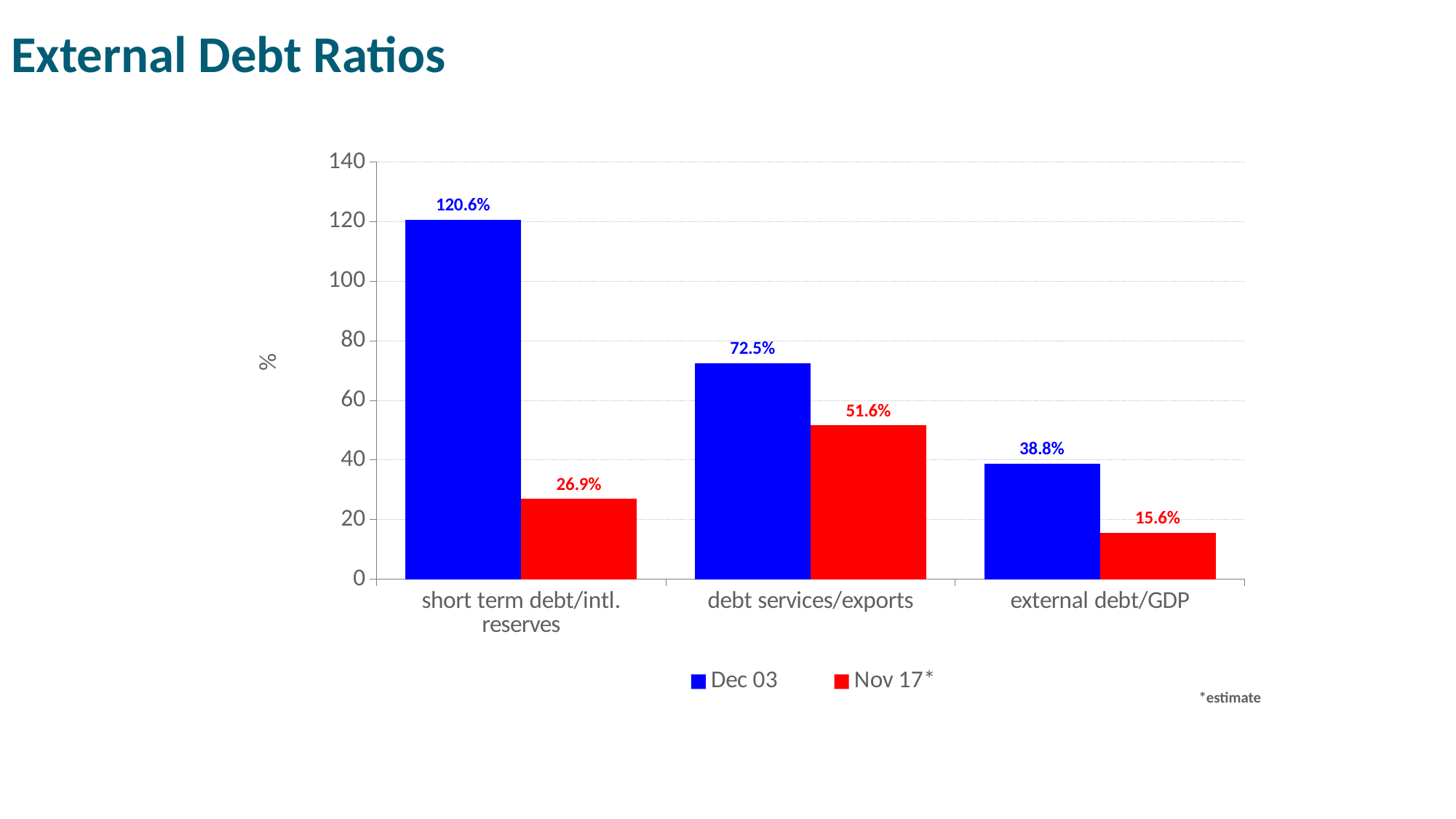
Which category has the lowest Nov 17 value? external debt/GDP Which is larger for debt services/exports: the Dec 03 value or the Nov 17 value? Dec 03 What kind of chart is shown on the slide? bar chart Is the Dec 03 value for debt services/exports greater or less than 60? greater What is the Nov 17 value for debt services/exports? 51.6% What is the Nov 17 value for external debt/GDP? 15.6% Which category has the highest Dec 03 value? short term debt/intl. reserves How many series does the legend list? 2 What is the difference between the Dec 03 and Nov 17 values for short term debt/intl. reserves? 93.7% How many categories are shown on the x axis? 3 What is the Dec 03 value for short term debt/intl. reserves? 120.6% What is the difference between the Dec 03 and Nov 17 values for external debt/GDP? 23.2%